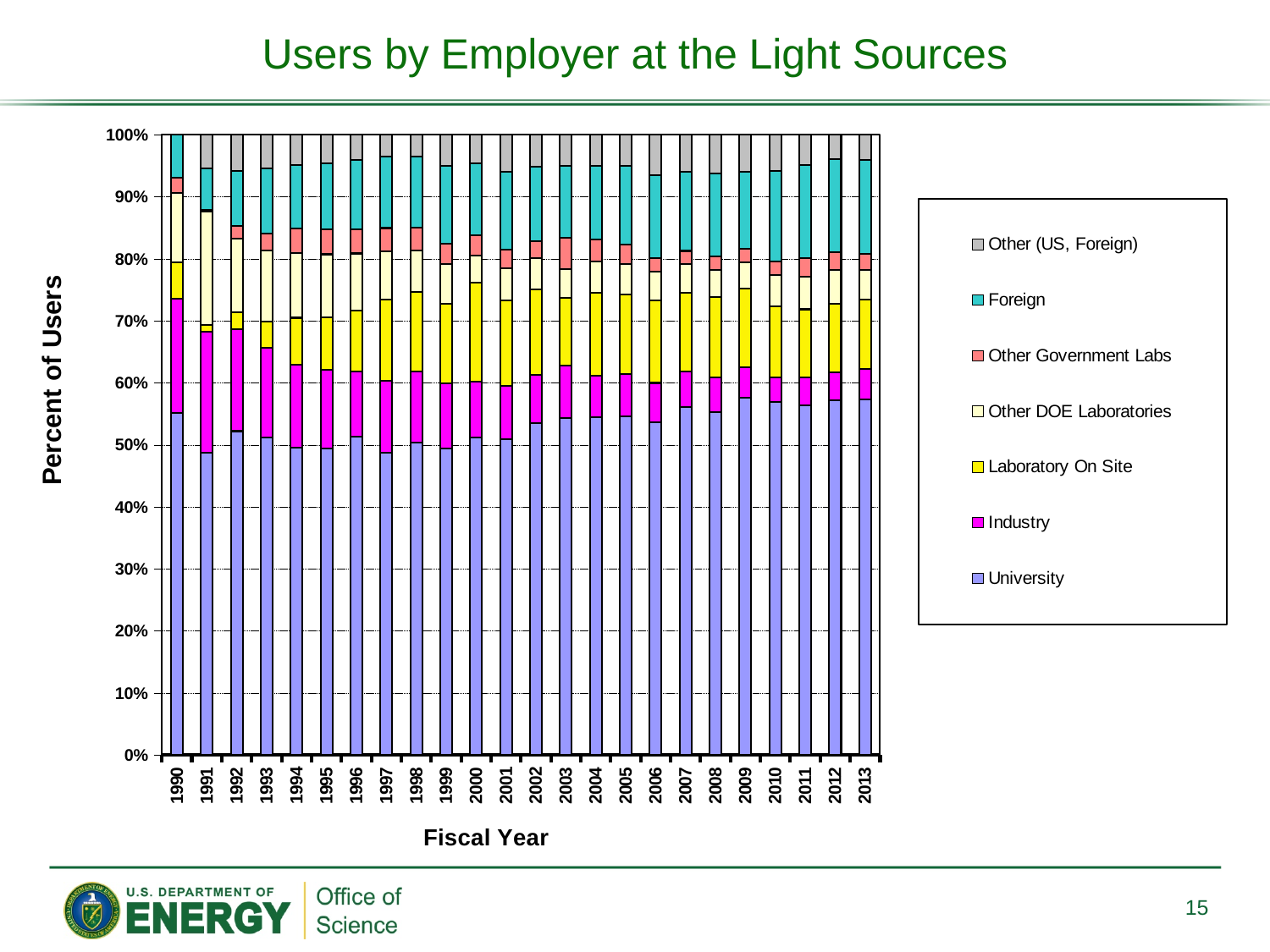
How many series does the chart's legend list? 7 What is the label of the x axis? Fiscal Year Which year has the larger University share of users, 1991 or 2013? 2013 Is the University share of users in 1990 greater or less than 50%? greater How many fiscal years are shown along the x axis of the chart? 24 What is the total of the stacked bar for 2000? 100% Which year has the larger Industry share of users, 1990 or 2013? 1990 Which year has the larger Laboratory On Site share of users, 1990 or 2005? 2005 What kind of chart is shown on the slide? Stacked bar chart Is the University share of users in 2010 greater or less than 50%? greater What is the title of the chart? Users by Employer at the Light Sources Is the University share of users in 2013 greater or less than 50%? greater